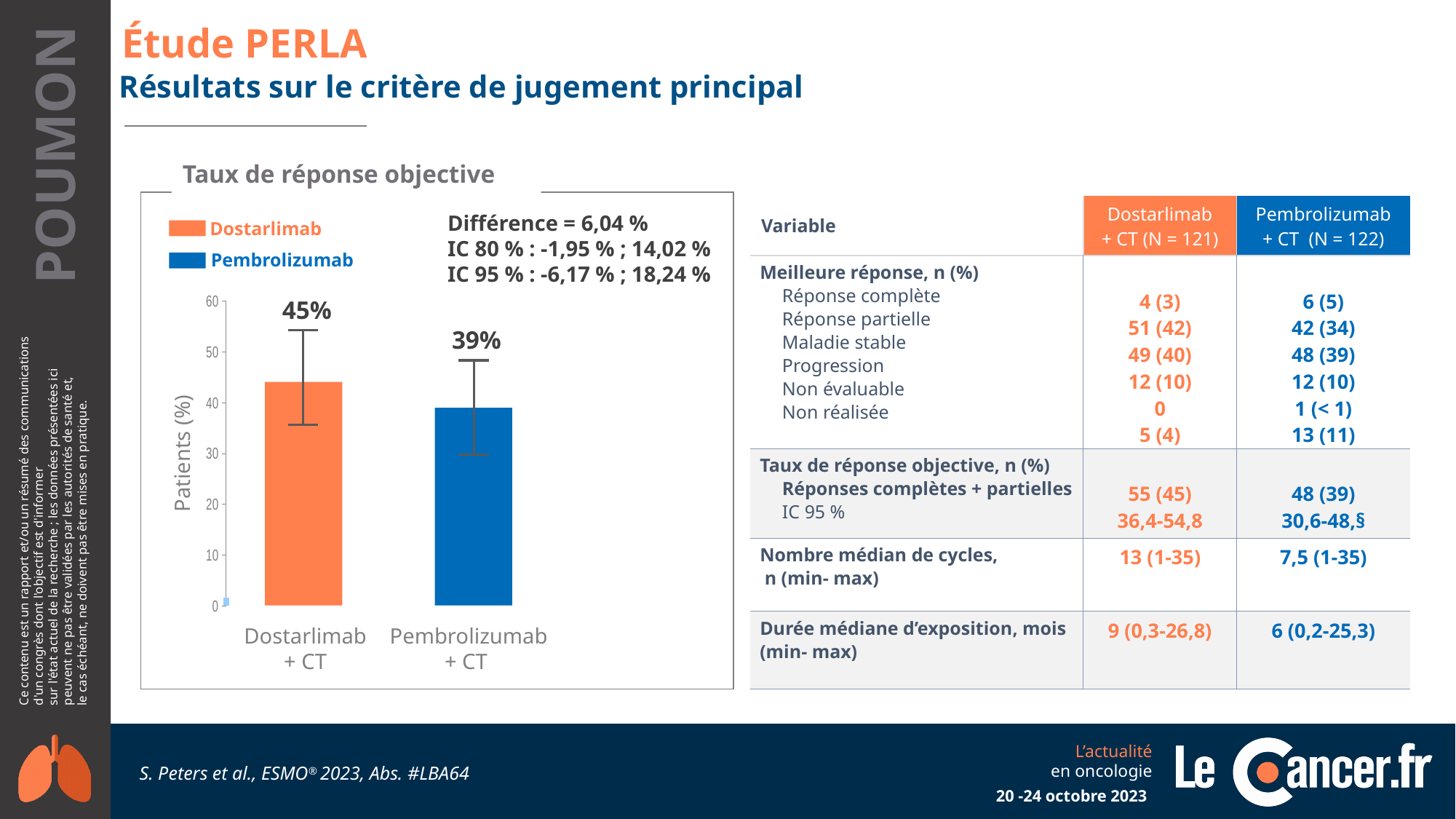
Is the value for Pembrolizumab + CT greater or less than 40? less How many entries does the chart legend list? 2 What is the objective response rate shown for Dostarlimab + CT in the bar chart? 45% Which treatment arm has the higher objective response rate in the bar chart? Dostarlimab + CT What type of chart is used to show the objective response rate? bar chart Which treatment arm has the lower objective response rate in the bar chart? Pembrolizumab + CT What is the difference in percentage points between the Dostarlimab + CT bar (45%) and the Pembrolizumab + CT bar (39%)? 6 How many bars are plotted in the chart? 2 What is the objective response rate shown for Pembrolizumab + CT in the bar chart? 39% What is the title of the chart? Taux de réponse objective Is the bar for Dostarlimab + CT taller or shorter than the bar for Pembrolizumab + CT? taller What is the label of the y axis of the chart? Patients (%)